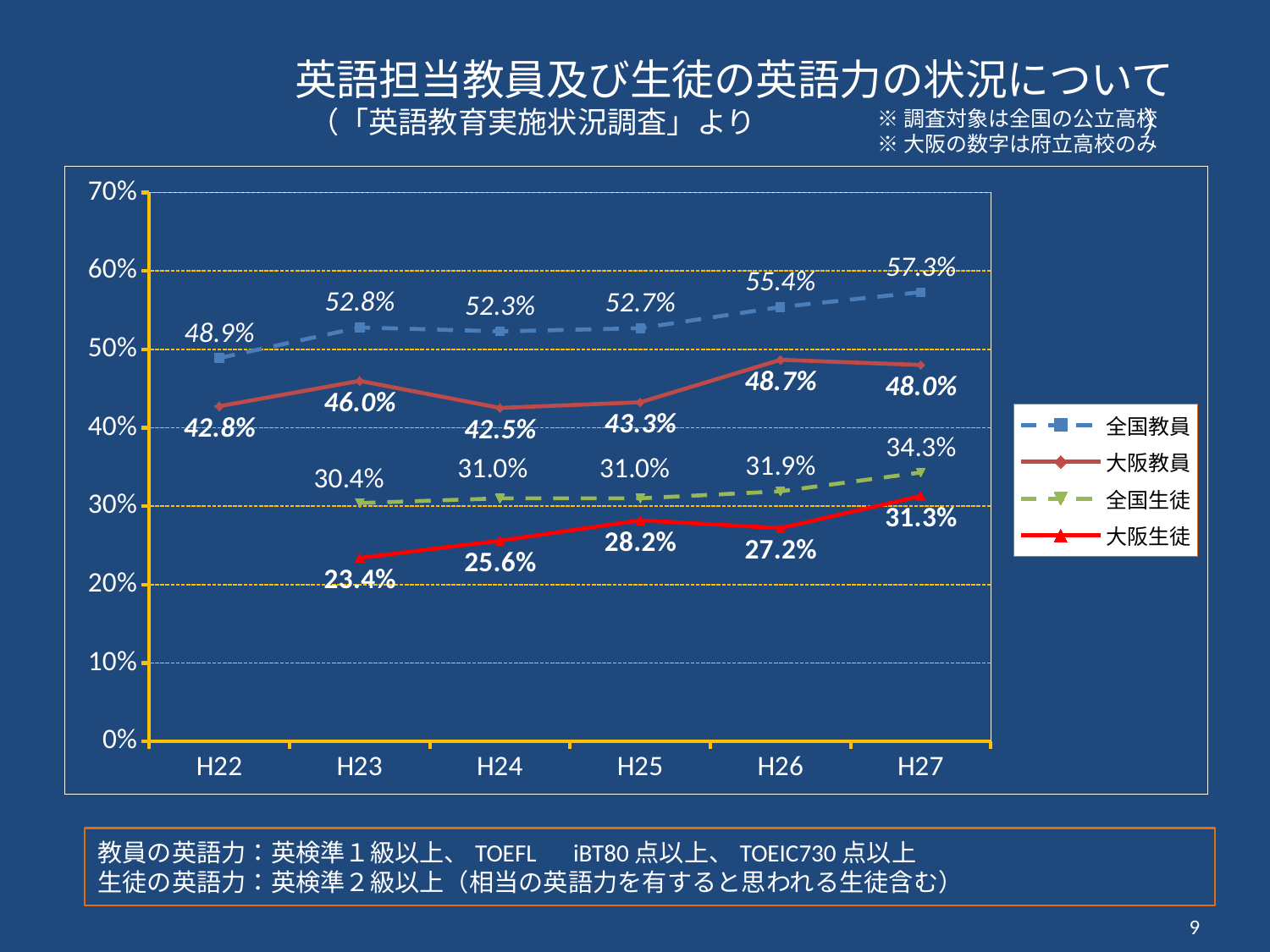
Which is larger in H26: 全国生徒 or 大阪生徒? 全国生徒 In which year is the 大阪生徒 value lowest? H23 Does the 全国教員 series rise or fall from H25 to H27? rise In which year is the 大阪教員 value highest? H26 What type of chart is shown on the slide? line chart How many series does the legend list? 4 What is the value for 全国生徒 in H26? 31.9% What is the value for 大阪教員 in H24? 42.5% How many years are shown on the x axis? 6 What is the value for 全国教員 in H27? 57.3% What is the difference between 全国教員 and 大阪教員 in H27? 9.3% What is the value for 大阪生徒 in H23? 23.4%